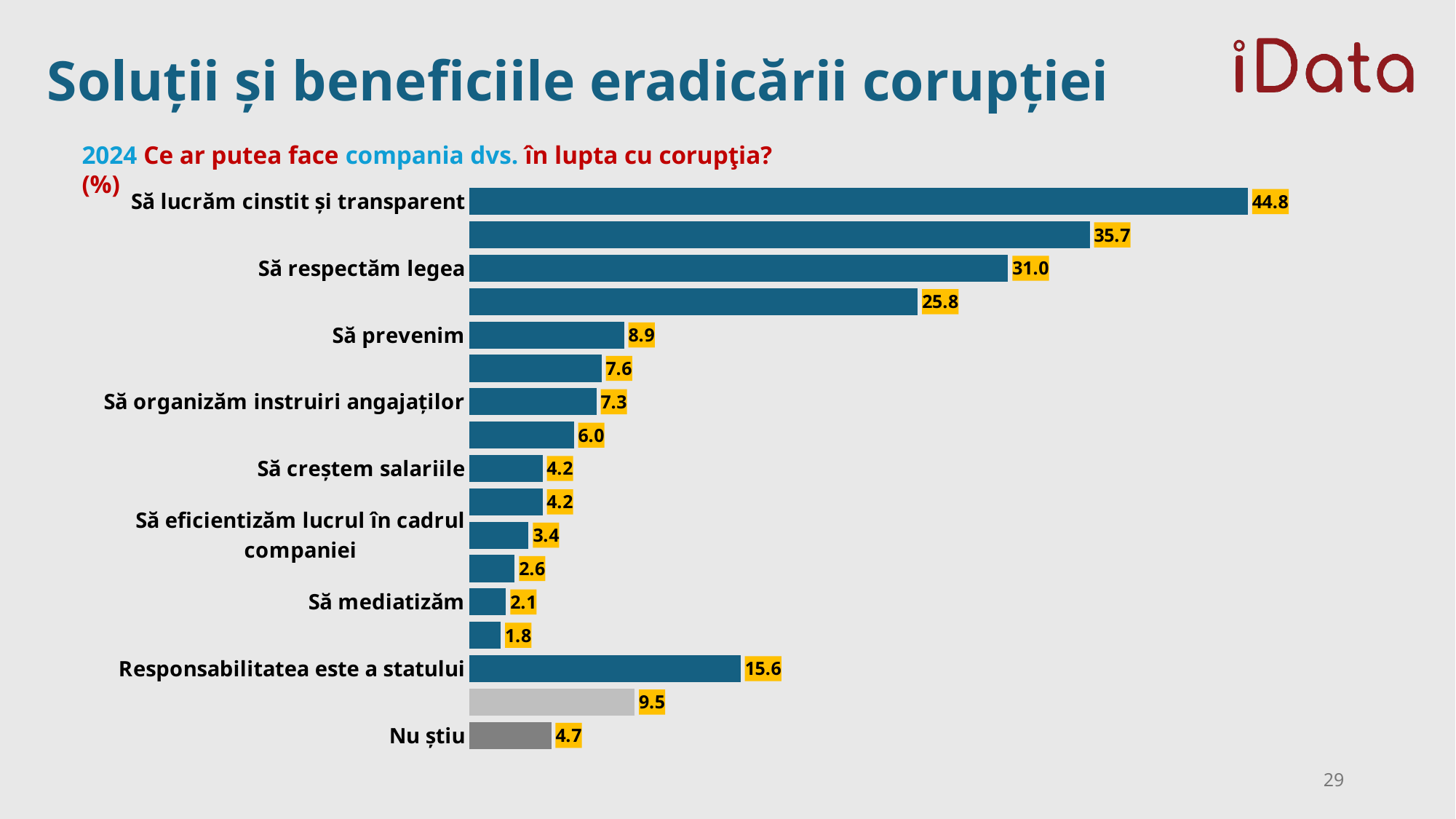
Which is larger: the value for "Să prevenim" or the value for "Responsabilitatea este a statului"? Responsabilitatea este a statului What kind of chart is shown on the slide? Bar chart What year is indicated in the chart's subtitle? 2024 What is the value for "Să lucrăm cinstit și transparent"? 44.8 What is the value for "Nu știu"? 4.7 What is the value for "Să prevenim"? 8.9 What is the value for "Să respectăm legea"? 31.0 What is the value for "Responsabilitatea este a statului"? 15.6 What is the smallest value shown on any bar in the chart? 1.8 How many bars are plotted in the chart? 17 Which labeled category has the highest value? Să lucrăm cinstit și transparent What is the difference between the values for "Să lucrăm cinstit și transparent" and "Să respectăm legea"? 13.8